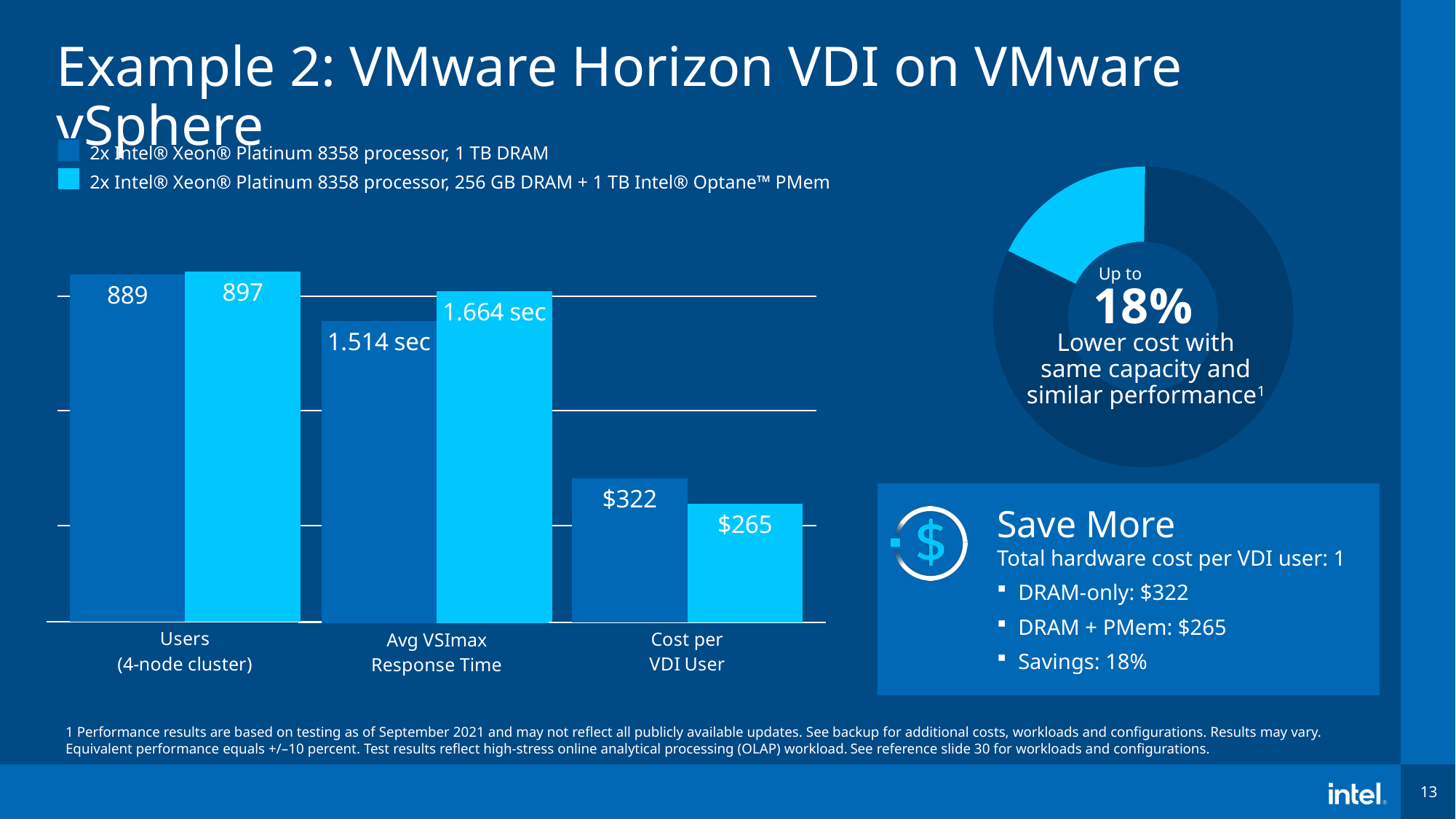
In the bar chart, what is the number of users (4-node cluster) for the 1 TB DRAM configuration? 889 How many series does the legend of the bar chart list? 2 In the bar chart, which configuration has the longer Avg VSImax Response Time? 2x Intel Xeon Platinum 8358 processor, 256 GB DRAM + 1 TB Intel Optane PMem What percentage does the donut chart on the right highlight? 18% In the bar chart, which configuration has the higher Cost per VDI User? 2x Intel Xeon Platinum 8358 processor, 1 TB DRAM In the bar chart, what is the difference in Cost per VDI User between the 1 TB DRAM configuration and the DRAM + PMem configuration? $57 In the bar chart, what is the Cost per VDI User for the 1 TB DRAM configuration? $322 In the bar chart, what is the number of users (4-node cluster) for the 256 GB DRAM + 1 TB Intel Optane PMem configuration? 897 In the bar chart, what is the Cost per VDI User for the 256 GB DRAM + 1 TB Intel Optane PMem configuration? $265 In the bar chart, what is the Avg VSImax Response Time for the 256 GB DRAM + 1 TB Intel Optane PMem configuration? 1.664 sec In the bar chart, what is the Avg VSImax Response Time for the 1 TB DRAM configuration? 1.514 sec How many categories are shown on the x axis of the bar chart? 3